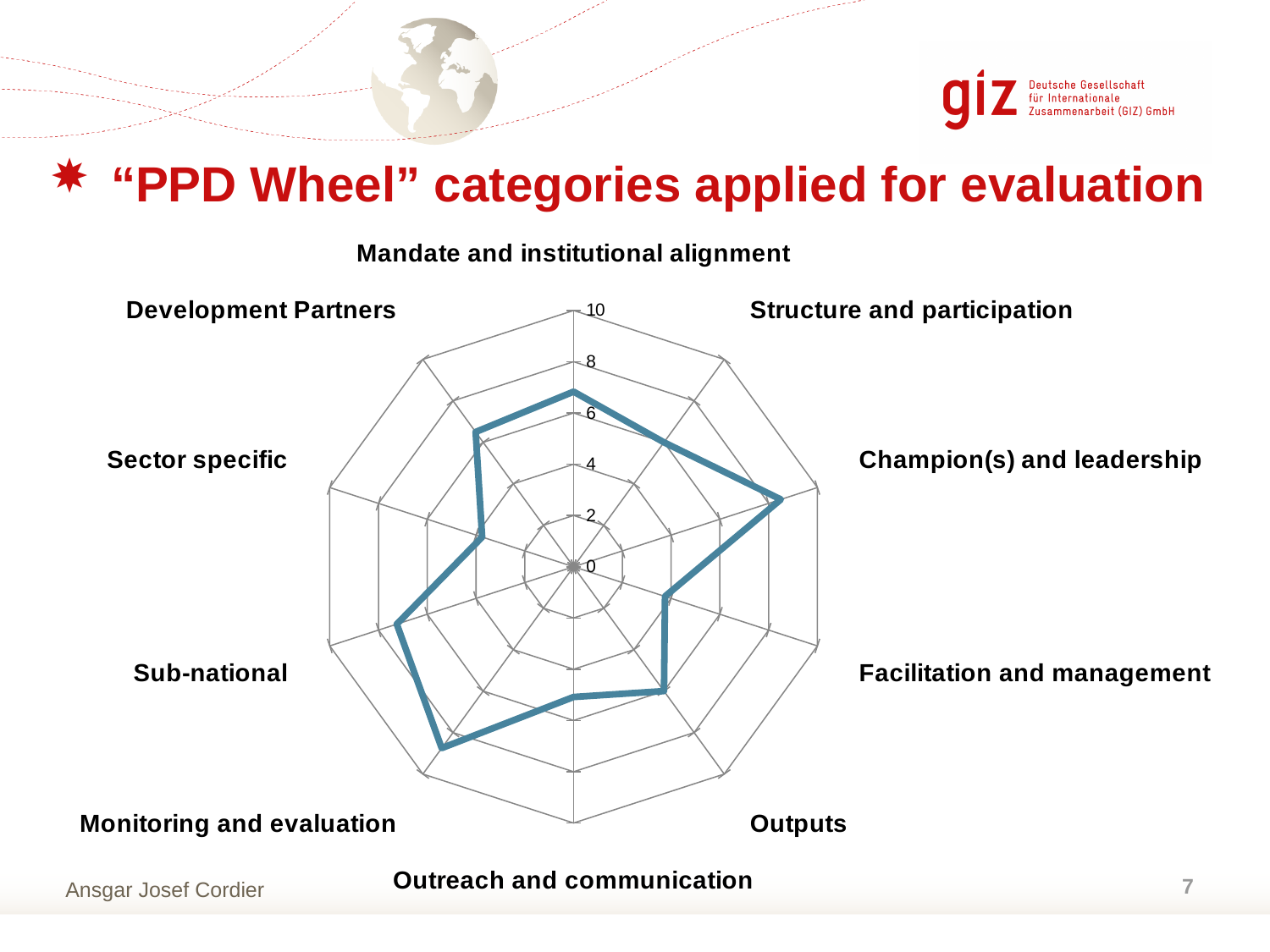
Is the value for Champion(s) and leadership greater or less than 6? greater Which has the larger value, Champion(s) and leadership or Facilitation and management? Champion(s) and leadership How many data series are plotted on the radar chart? 1 How many categories are plotted on the radar chart? 10 Is the value for Monitoring and evaluation greater or less than 6? greater Is the value for Sub-national greater or less than 4? greater What is the maximum value shown on the chart's axis scale? 10 What kind of chart is shown on the slide? Radar chart Which has the larger value, Sub-national or Sector specific? Sub-national